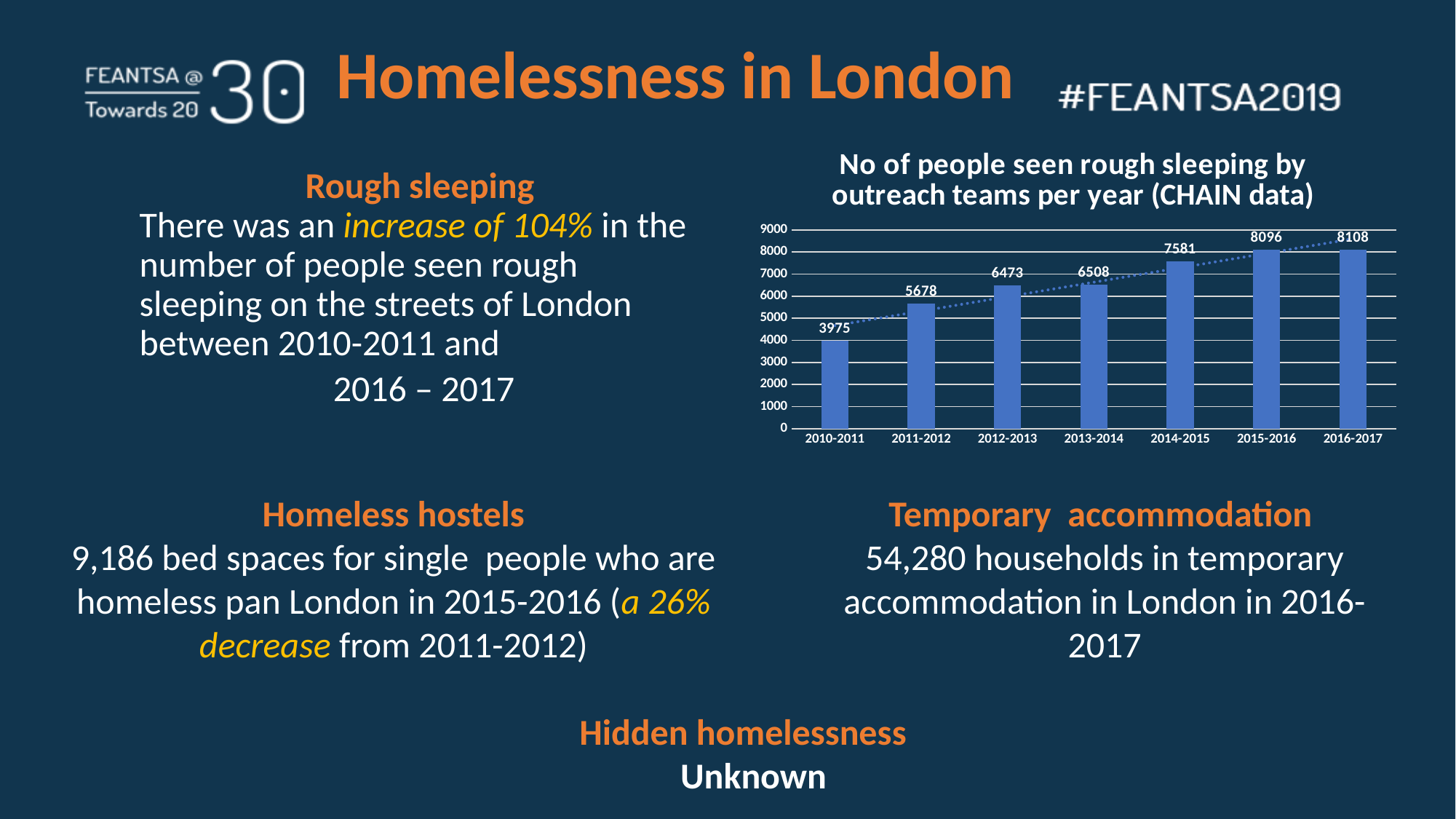
What is the difference between the values for 2016-2017 and 2010-2011? 4133 Do the values in the chart generally rise or fall from 2010-2011 to 2016-2017? Rise Which year has the lowest number of people seen rough sleeping? 2010-2011 Which is larger, the value for 2012-2013 or the value for 2011-2012? 2012-2013 What type of chart is shown on the slide? Bar chart What is the value shown for 2013-2014? 6508 How many year categories are shown on the x axis of the chart? 7 What is the value shown for 2016-2017? 8108 How many people were seen rough sleeping by outreach teams in 2010-2011? 3975 What is the title of the chart on the slide? No of people seen rough sleeping by outreach teams per year (CHAIN data) What is the difference between the values for 2014-2015 and 2013-2014? 1073 Which year has the highest number of people seen rough sleeping? 2016-2017